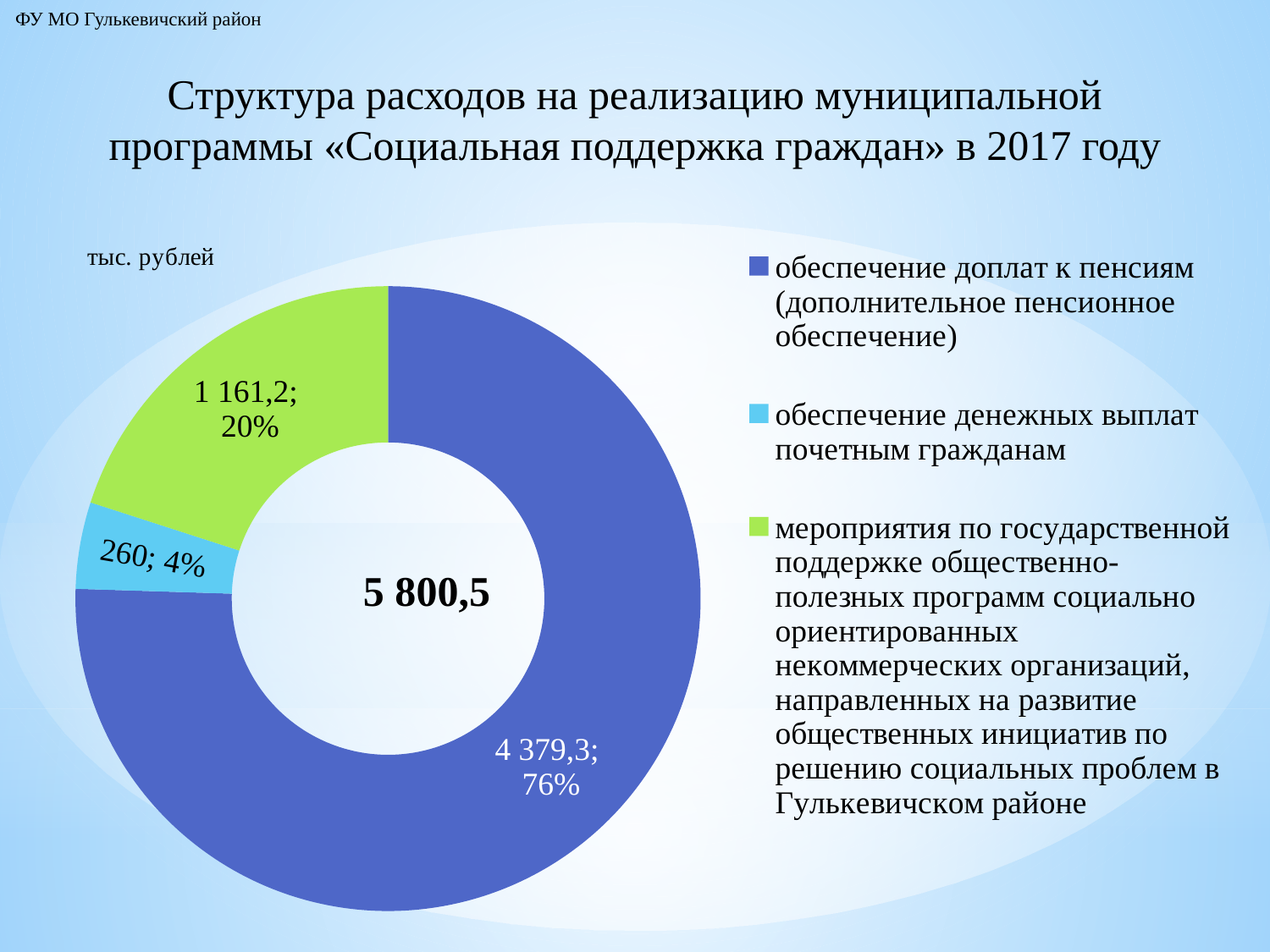
What unit of measurement is indicated for the chart values? тыс. рублей What is the value for «обеспечение денежных выплат почетным гражданам»? 260 What share of the chart does «обеспечение доплат к пенсиям» take? 76% How many entries does the legend list? 3 Which category has the largest value? обеспечение доплат к пенсиям (дополнительное пенсионное обеспечение) What kind of chart is shown on the slide? Doughnut (pie) chart What is the total shown in the centre of the chart? 5 800,5 Which category has the smallest value? обеспечение денежных выплат почетным гражданам What is the value for «обеспечение доплат к пенсиям (дополнительное пенсионное обеспечение)»? 4 379,3 How many segments does the chart have? 3 What is the value for «мероприятия по государственной поддержке общественно-полезных программ социально ориентированных некоммерческих организаций...»? 1 161,2 What share of the chart does «обеспечение денежных выплат почетным гражданам» take? 4%